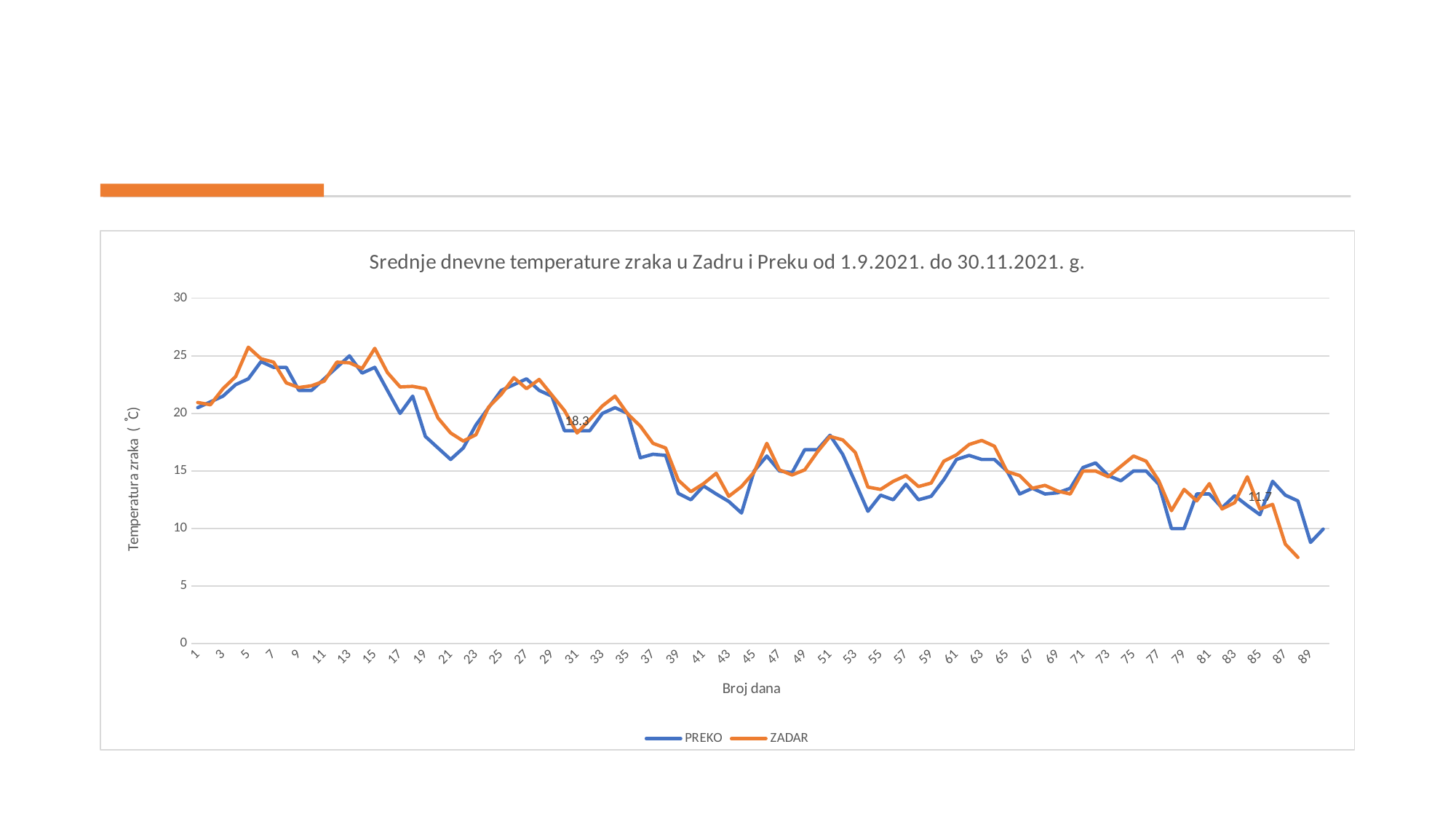
At day 88, which series has the higher value, PREKO or ZADAR? PREKO Is the PREKO value at day 51 greater or less than 15? greater How many series does the legend list? 2 Is the PREKO value at day 21 greater or less than 20? less Overall, do the temperature values rise or fall from day 1 to day 89? fall What are the two series named in the legend? PREKO and ZADAR What is the title of the x axis? Broj dana Is the PREKO value at day 89 greater or less than 15? less Which series reaches the lowest value anywhere on the chart? ZADAR What kind of chart is shown on the slide? line chart At day 21, which series has the higher value, PREKO or ZADAR? ZADAR